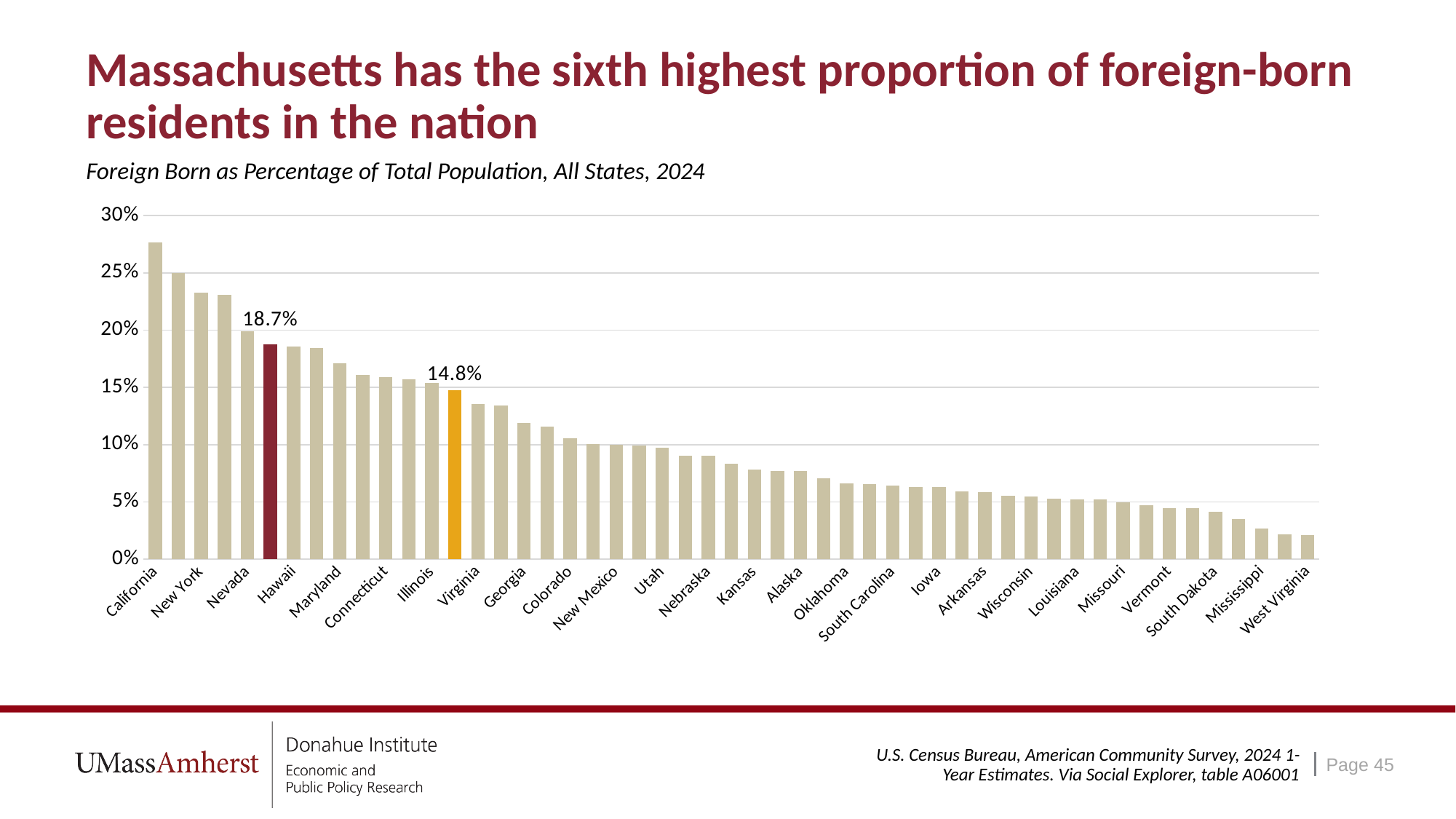
Is the value for California greater or less than 25%? greater Is the value for Kansas greater or less than 10%? less What is the subtitle printed above the chart? Foreign Born as Percentage of Total Population, All States, 2024 What kind of chart is shown on the slide? bar chart Which state has the highest proportion of foreign-born residents? California What is the difference between the two labelled values, 18.7% and 14.8%? 3.9% Which has a higher foreign-born percentage, Nevada or Maryland? Nevada Is the value for West Virginia greater or less than 5%? less Do the values rise or fall moving from left to right along the x axis? fall What value is printed above the dark red highlighted bar? 18.7%